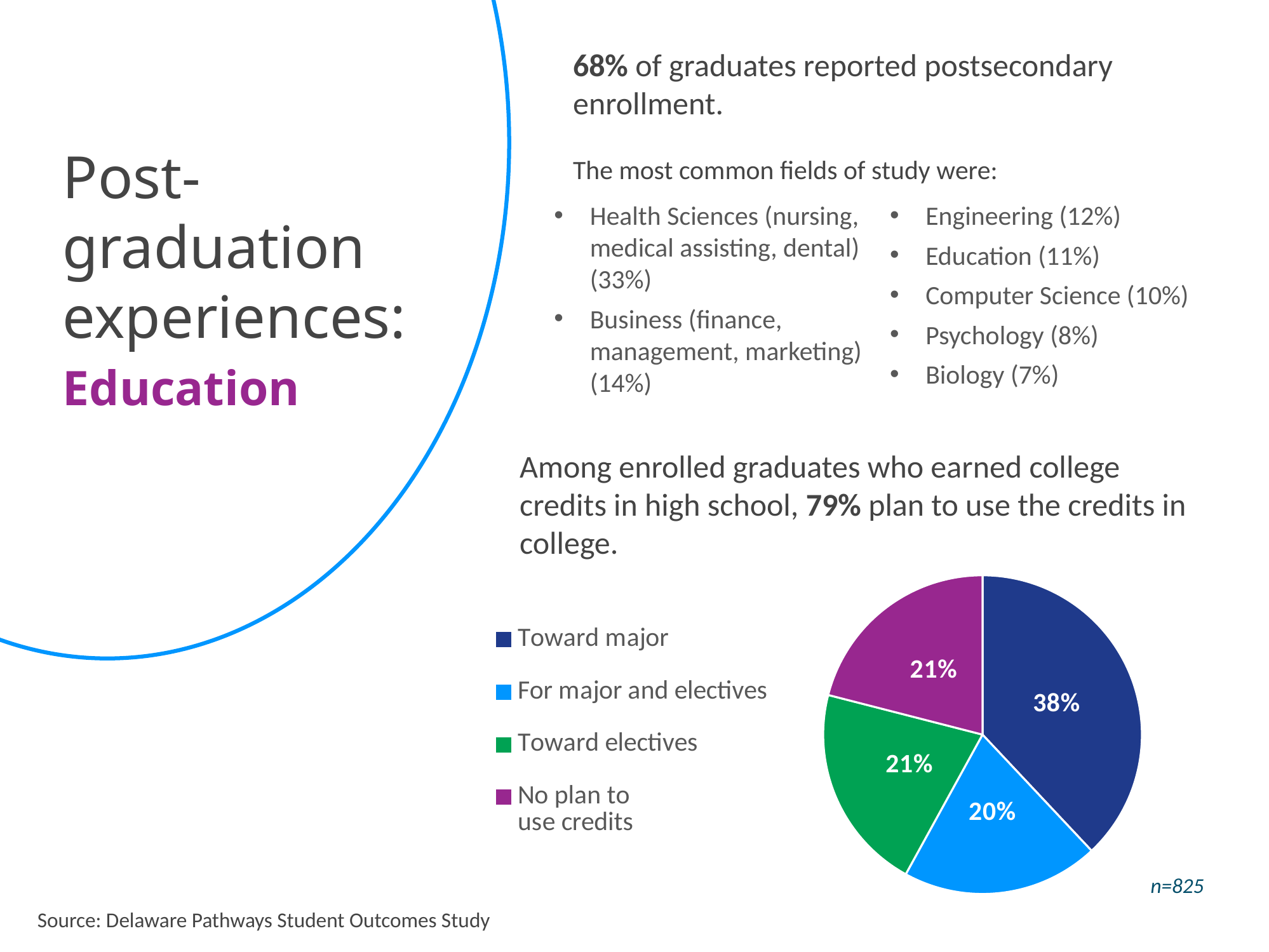
What percentage of the pie chart is "No plan to use credits"? 21% What is the difference in percentage points between the "Toward major" slice and the "For major and electives" slice? 18 Which is larger in the pie chart: "Toward major" or "Toward electives"? Toward major What sample size is noted next to the pie chart? n=825 What value is shown for the "Toward electives" slice of the pie chart? 21% Which category has the smallest slice in the pie chart? For major and electives Which category has the largest slice in the pie chart? Toward major What colour is the "No plan to use credits" slice in the pie chart? Purple What share of the pie chart is labelled "Toward major"? 38% What type of chart is shown on the slide? Pie chart What percentage of the pie chart corresponds to "For major and electives"? 20% How many slices does the pie chart have? 4